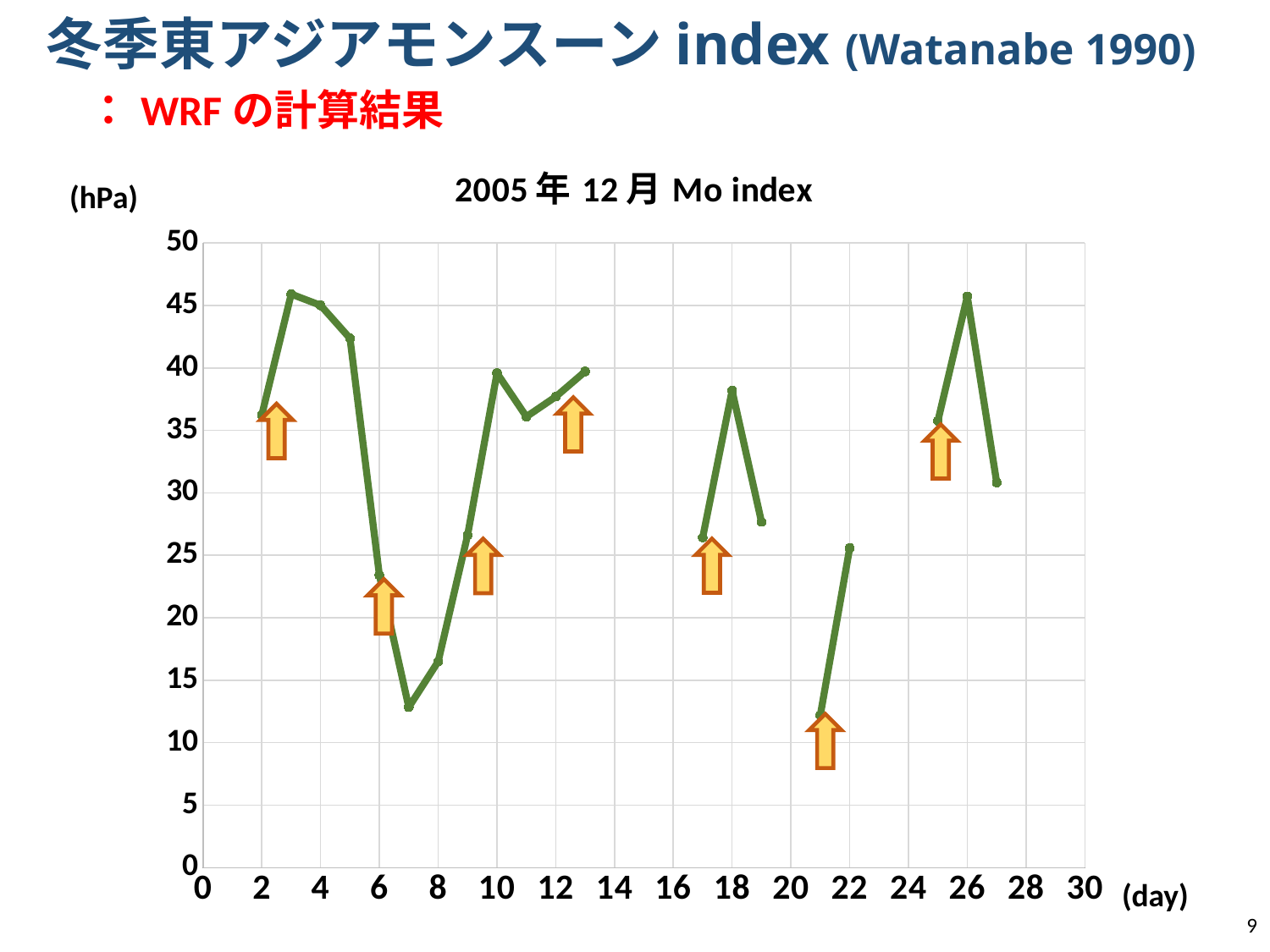
Which is larger, the value on day 2 or the value on day 7? day 2 Is the value on day 18 greater or less than 35? greater Is the value on day 26 greater or less than 40? greater Is the value on day 7 greater or less than 15? less Do the values rise or fall from day 3 to day 7? fall What unit is shown on the vertical axis of the chart? hPa What kind of chart is shown on the slide? line chart What is the title of the chart? 2005 年 12 月 Mo index Do the values rise or fall from day 7 to day 10? rise